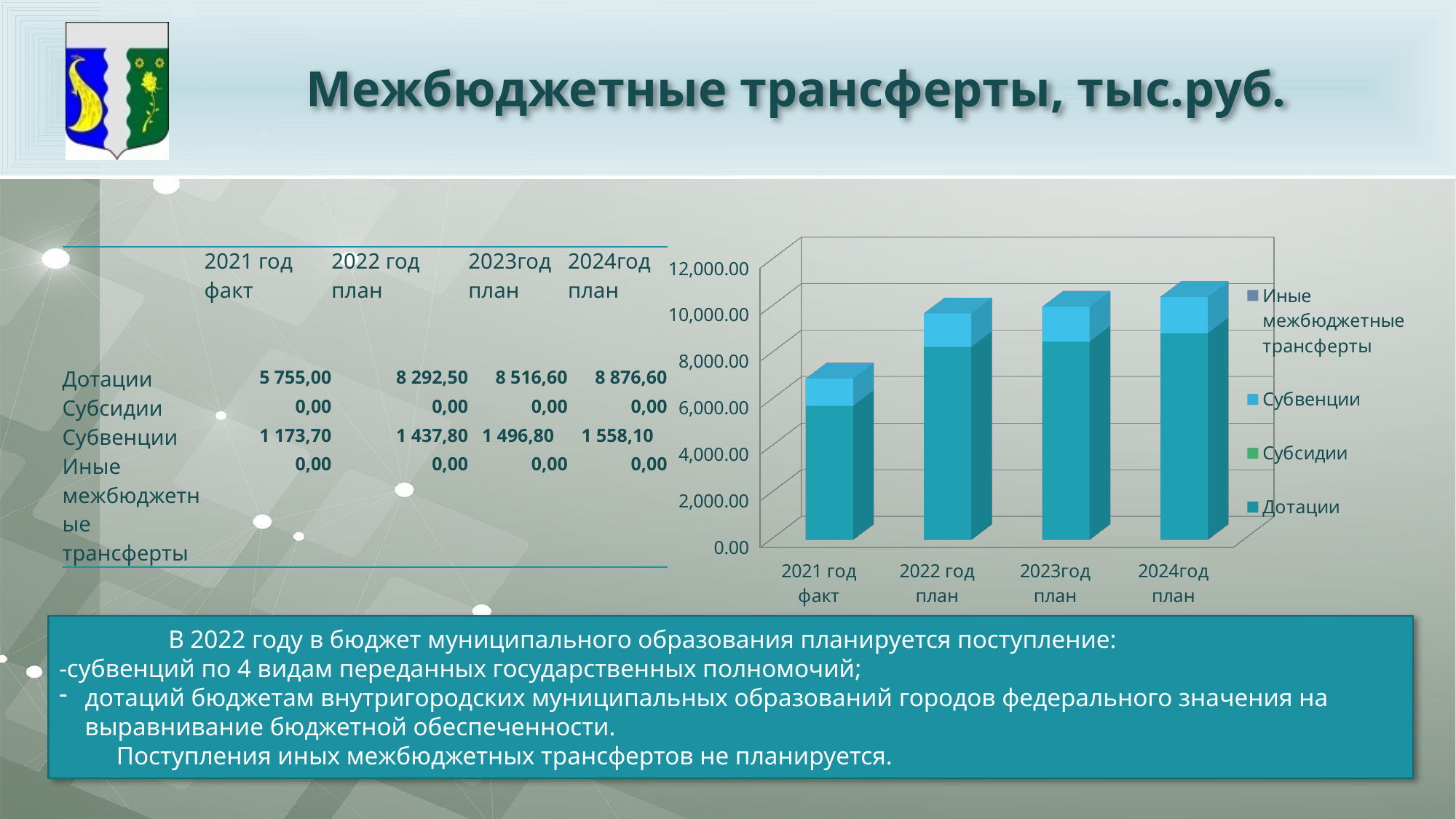
What is the total of the stacked bar for 2021 год факт? 6 928,70 Which series is shown at the bottom of each stacked bar? Дотации What is the value of Дотации for 2022 год план? 8 292,50 What is the value of Субвенции for 2024год план? 1 558,10 Is the total bar for 2024год план greater or less than 10,000.00? greater What kind of chart is shown on the slide? Stacked bar chart Is the total bar for 2021 год факт greater or less than 8,000.00? less Which year has the highest total of межбюджетные трансферты in the chart? 2024год план How many series does the chart legend list? 4 Which year has the lowest total of межбюджетные трансферты in the chart? 2021 год факт How many year categories are shown on the x axis of the chart? 4 Do the total heights of the stacked bars rise or fall from 2021 год факт to 2024год план? Rise